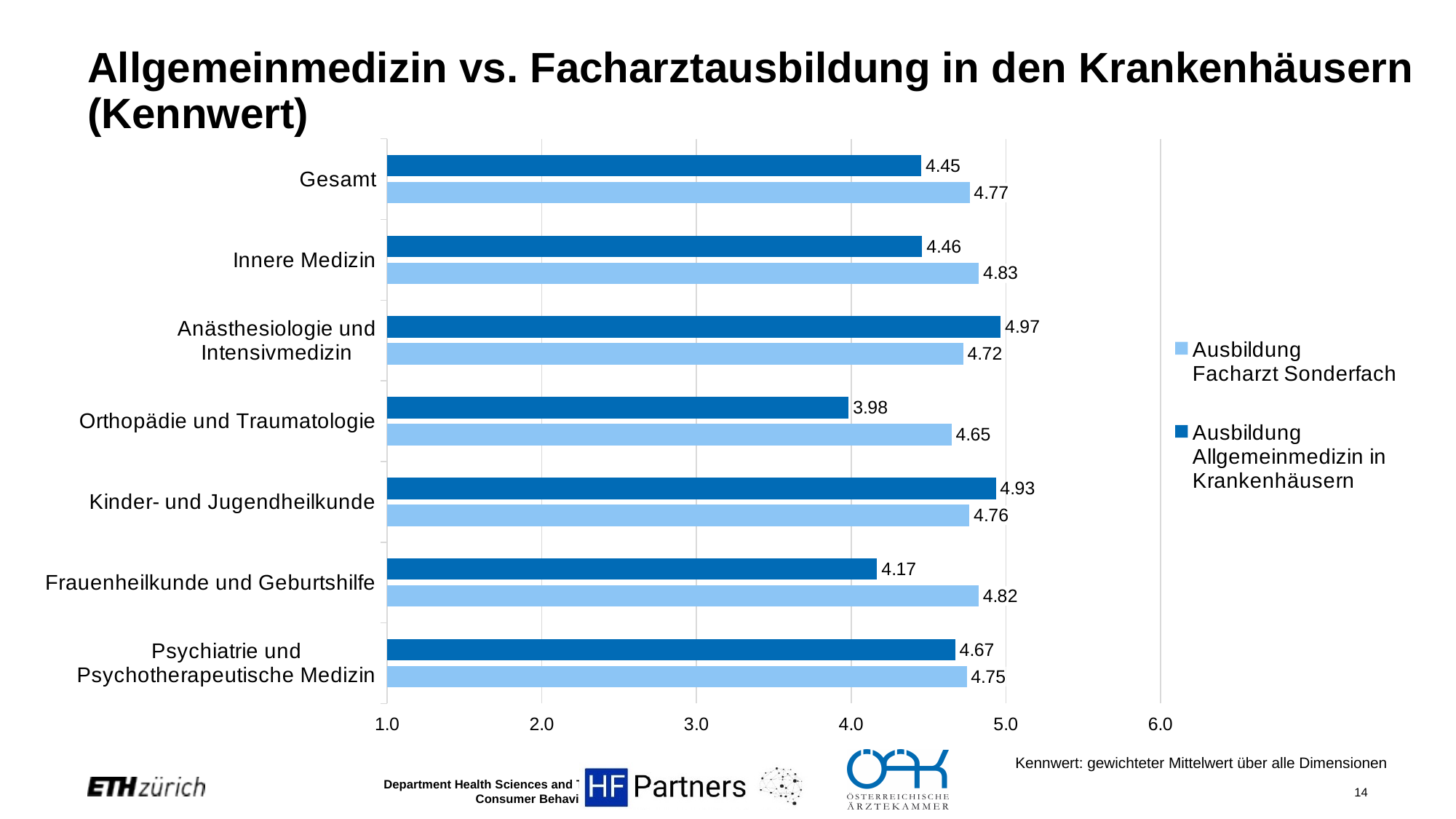
What is the difference between the Ausbildung Facharzt Sonderfach and Ausbildung Allgemeinmedizin in Krankenhäusern values for Gesamt? 0.32 Is the value for Ausbildung Allgemeinmedizin in Krankenhäusern for Frauenheilkunde und Geburtshilfe greater or less than 5.0? less Which series is shown in dark blue? Ausbildung Allgemeinmedizin in Krankenhäusern What kind of chart is shown on the slide? bar chart How many series does the legend list? 2 How many categories are shown on the chart? 7 What is the value for Ausbildung Allgemeinmedizin in Krankenhäusern for Gesamt? 4.45 Which category has the highest value for Ausbildung Allgemeinmedizin in Krankenhäusern? Anästhesiologie und Intensivmedizin What is the value for Ausbildung Allgemeinmedizin in Krankenhäusern for Orthopädie und Traumatologie? 3.98 For Kinder- und Jugendheilkunde, which series has the larger value: Ausbildung Facharzt Sonderfach or Ausbildung Allgemeinmedizin in Krankenhäusern? Ausbildung Allgemeinmedizin in Krankenhäusern Which category has the lowest value for Ausbildung Facharzt Sonderfach? Orthopädie und Traumatologie What is the value for Ausbildung Facharzt Sonderfach for Innere Medizin? 4.83